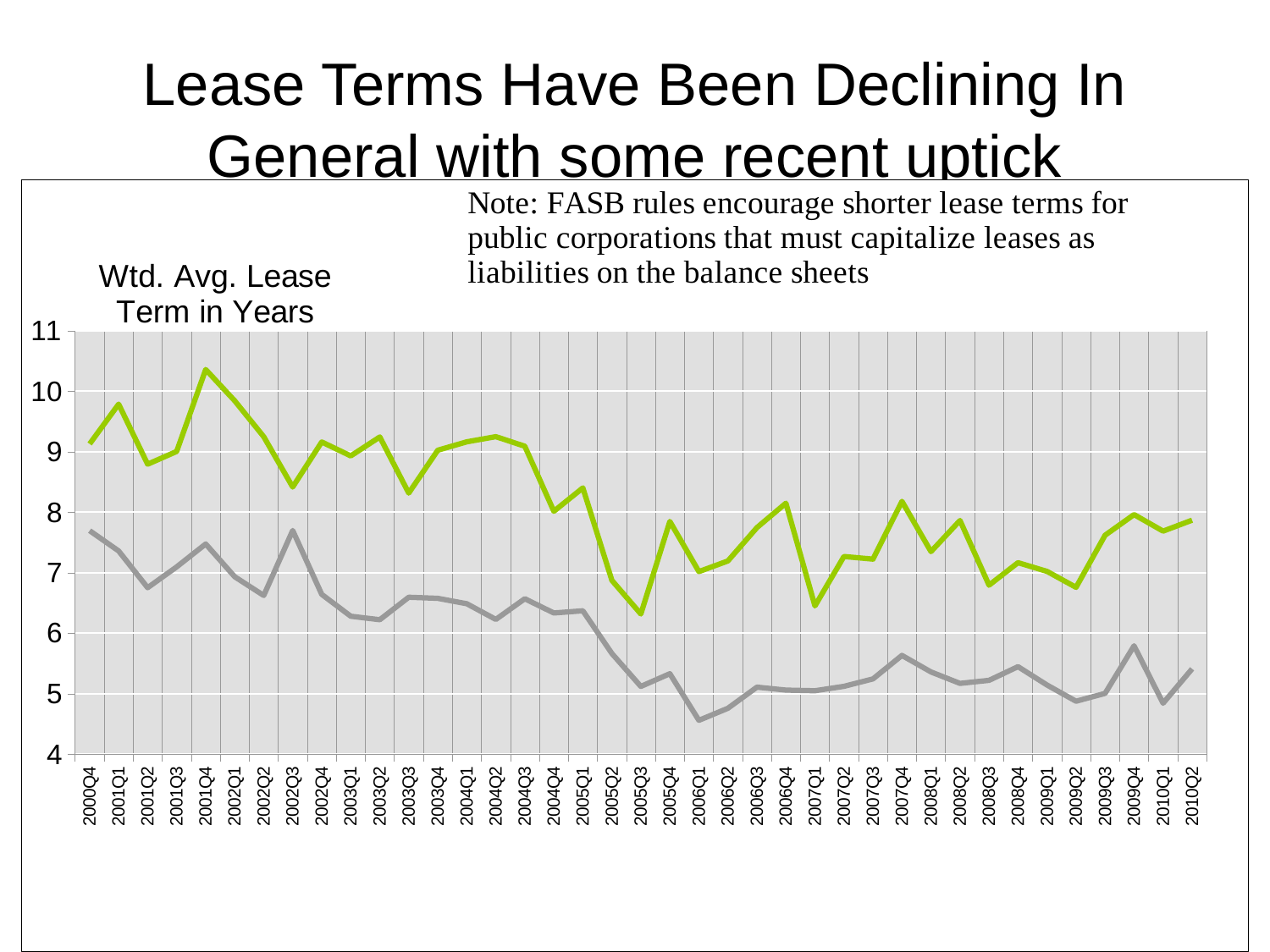
How many quarterly points are on the x axis of the chart? 39 Is the value of the green line at 2005Q3 greater or less than 7? less What is the label shown above the chart's y axis? Wtd. Avg. Lease Term in Years Is the value of the gray line at 2006Q1 greater or less than 5? less Overall, do the values of the gray line rise or fall from 2000Q4 to 2010Q2? fall In which quarter does the green line reach its highest value? 2001Q4 Is the value of the green line at 2001Q4 greater or less than 10? greater What kind of chart is shown on the slide? line chart How many lines are plotted on the chart? 2 At 2000Q4, which line has the higher value, the green line or the gray line? the green line In which quarter does the gray line reach its lowest value? 2006Q1 What are the first and last quarters shown on the x axis? 2000Q4 and 2010Q2